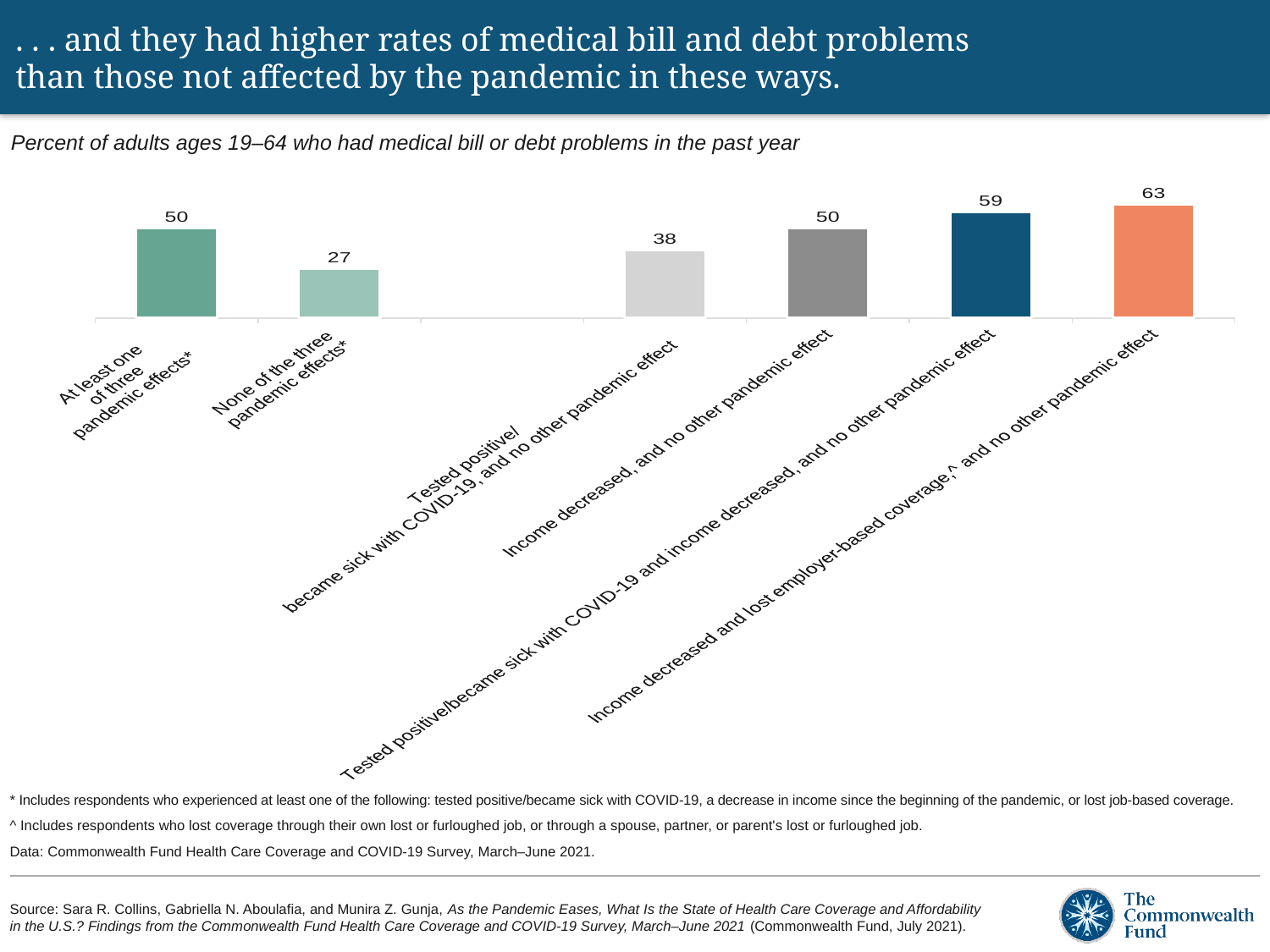
What is the value for adults who tested positive/became sick with COVID-19, and no other pandemic effect? 38 Which category has the highest percentage of adults with medical bill or debt problems? Income decreased and lost employer-based coverage, and no other pandemic effect What type of chart is shown on the slide? Bar chart What is the difference between the value for adults with at least one of three pandemic effects and those with none of the three pandemic effects? 23 What is the value for adults with none of the three pandemic effects? 27 What is the difference between the value for adults who tested positive/became sick with COVID-19 and income decreased and the value for those whose income decreased and lost employer-based coverage? 4 What does the chart's subtitle say is being measured? Percent of adults ages 19–64 who had medical bill or debt problems in the past year Which category has the lowest percentage of adults with medical bill or debt problems? None of the three pandemic effects What is the value for adults with at least one of three pandemic effects? 50 What is the value for adults whose income decreased and lost employer-based coverage, and no other pandemic effect? 63 Which is larger: the value for adults who tested positive/became sick with COVID-19 and no other pandemic effect, or the value for adults whose income decreased and no other pandemic effect? Income decreased, and no other pandemic effect How many bars are plotted in the chart? 6